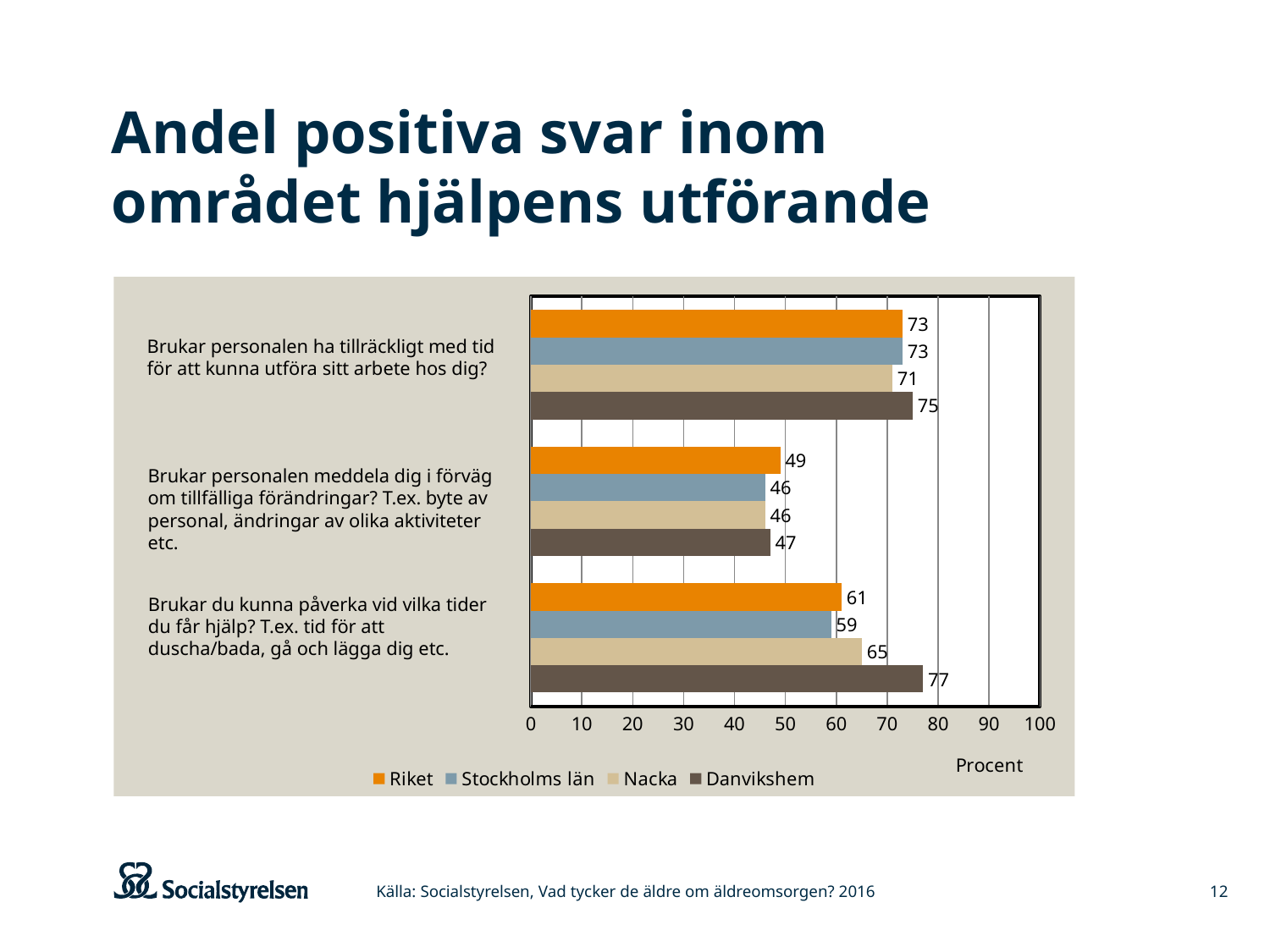
What is the value for Riket on the question "Brukar personalen meddela dig i förväg om tillfälliga förändringar?"? 49 What is the value for Nacka on the question "Brukar personalen ha tillräckligt med tid för att kunna utföra sitt arbete hos dig?"? 71 Which series has the highest value on the question "Brukar du kunna påverka vid vilka tider du får hjälp?"? Danvikshem How many series does the legend list? 4 What is the difference between Riket and Nacka on the question "Brukar personalen meddela dig i förväg om tillfälliga förändringar?"? 3 How many question categories are shown on the chart? 3 What is the value for Stockholms län on the question "Brukar du kunna påverka vid vilka tider du får hjälp?"? 59 What is the value for Danvikshem on the question "Brukar du kunna påverka vid vilka tider du får hjälp?"? 77 Which is larger on the question "Brukar personalen ha tillräckligt med tid för att kunna utföra sitt arbete hos dig?": Danvikshem or Nacka? Danvikshem Which series has the lowest value on the question "Brukar du kunna påverka vid vilka tider du får hjälp?"? Stockholms län What is the difference between Danvikshem and Riket on the question "Brukar du kunna påverka vid vilka tider du får hjälp?"? 16 What kind of chart is shown on the slide? Bar chart